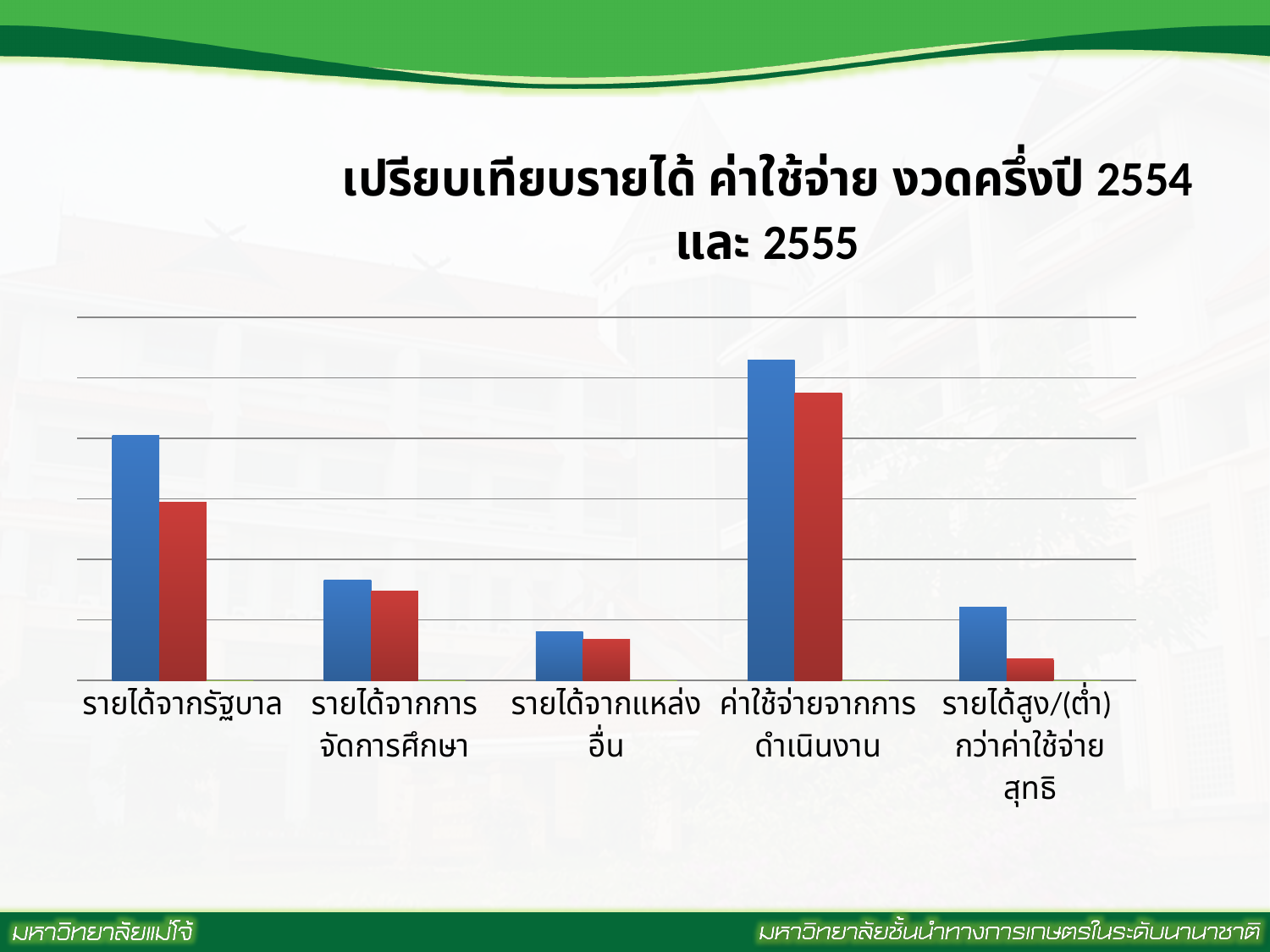
For รายได้สูง/(ต่ำ)กว่าค่าใช้จ่ายสุทธิ, which bar is taller, the blue one or the red one? blue What two colours are used for the bars in the chart? blue and red Which category has the shortest red bar? รายได้สูง/(ต่ำ)กว่าค่าใช้จ่ายสุทธิ How many categories are shown on the x axis of the chart? 5 How many bars are plotted for each category in the chart? 2 Which blue bar is taller: รายได้จากรัฐบาล or รายได้จากการจัดการศึกษา? รายได้จากรัฐบาล Which category has the tallest red bar? ค่าใช้จ่ายจากการดำเนินงาน Which category has the shortest blue bar? รายได้จากแหล่งอื่น For รายได้จากรัฐบาล, which bar is taller, the blue one or the red one? blue Which category has the tallest blue bar? ค่าใช้จ่ายจากการดำเนินงาน What is the title of the chart? เปรียบเทียบรายได้ ค่าใช้จ่าย งวดครึ่งปี 2554 และ 2555 What kind of chart is shown on the slide? bar chart